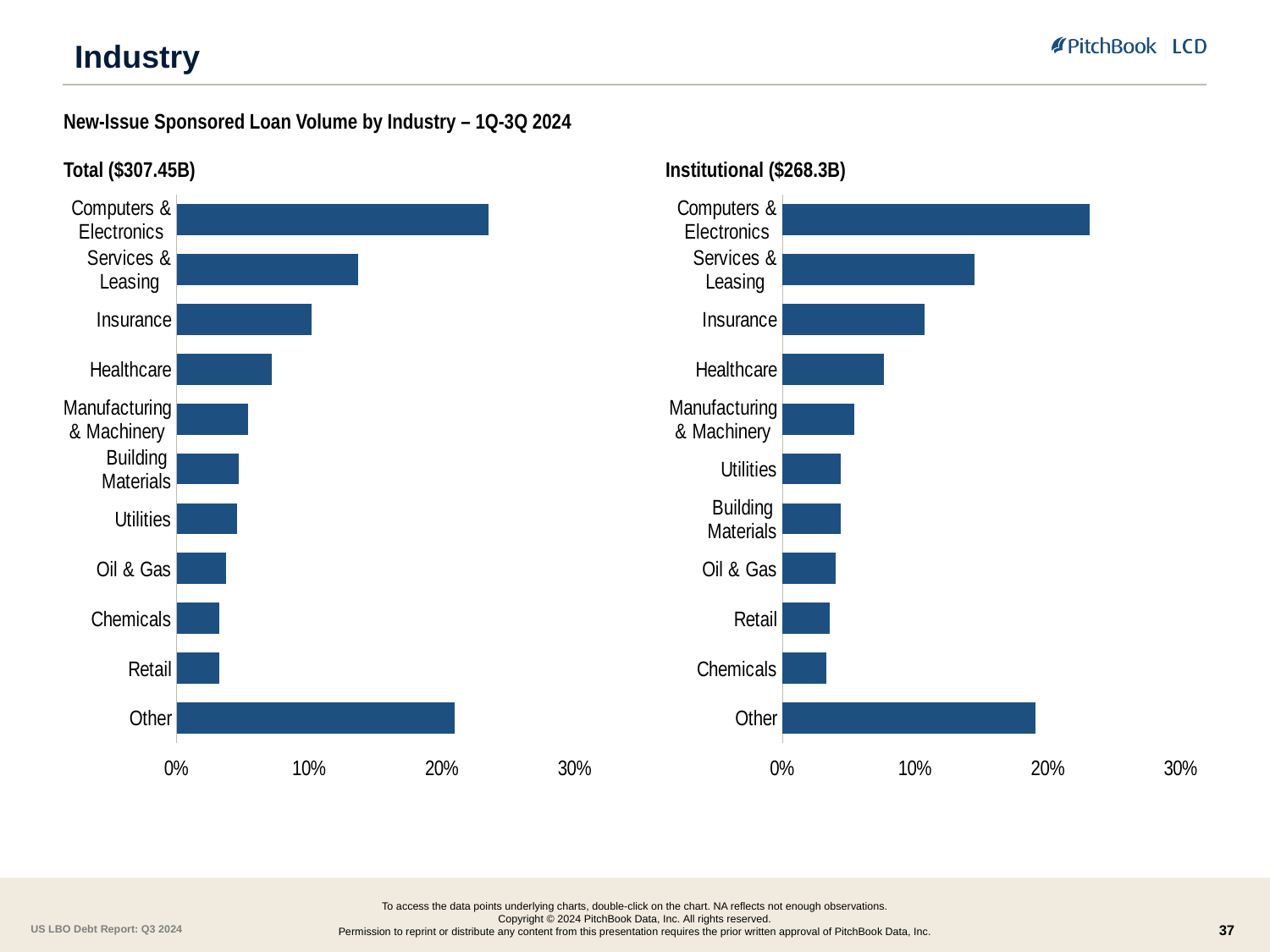
In the Institutional ($268.3B) chart, which industry has the highest share? Computers & Electronics What kind of chart is the Total ($307.45B) chart? bar chart How many industry categories are shown in the Institutional ($268.3B) chart? 11 What total dollar amount is given in the title of the left chart? $307.45B In the Institutional ($268.3B) chart, which is larger, Services & Leasing or Insurance? Services & Leasing In the Institutional ($268.3B) chart, is the value for Services & Leasing greater or less than 10%? greater In the Total ($307.45B) chart, which industry has the highest share? Computers & Electronics In the Institutional ($268.3B) chart, is the value for Other greater or less than 20%? less What is the overall title shown above the two charts? New-Issue Sponsored Loan Volume by Industry – 1Q-3Q 2024 In the Total ($307.45B) chart, which is larger, Computers & Electronics or Other? Computers & Electronics In the Total ($307.45B) chart, is the value for Computers & Electronics greater or less than 20%? greater